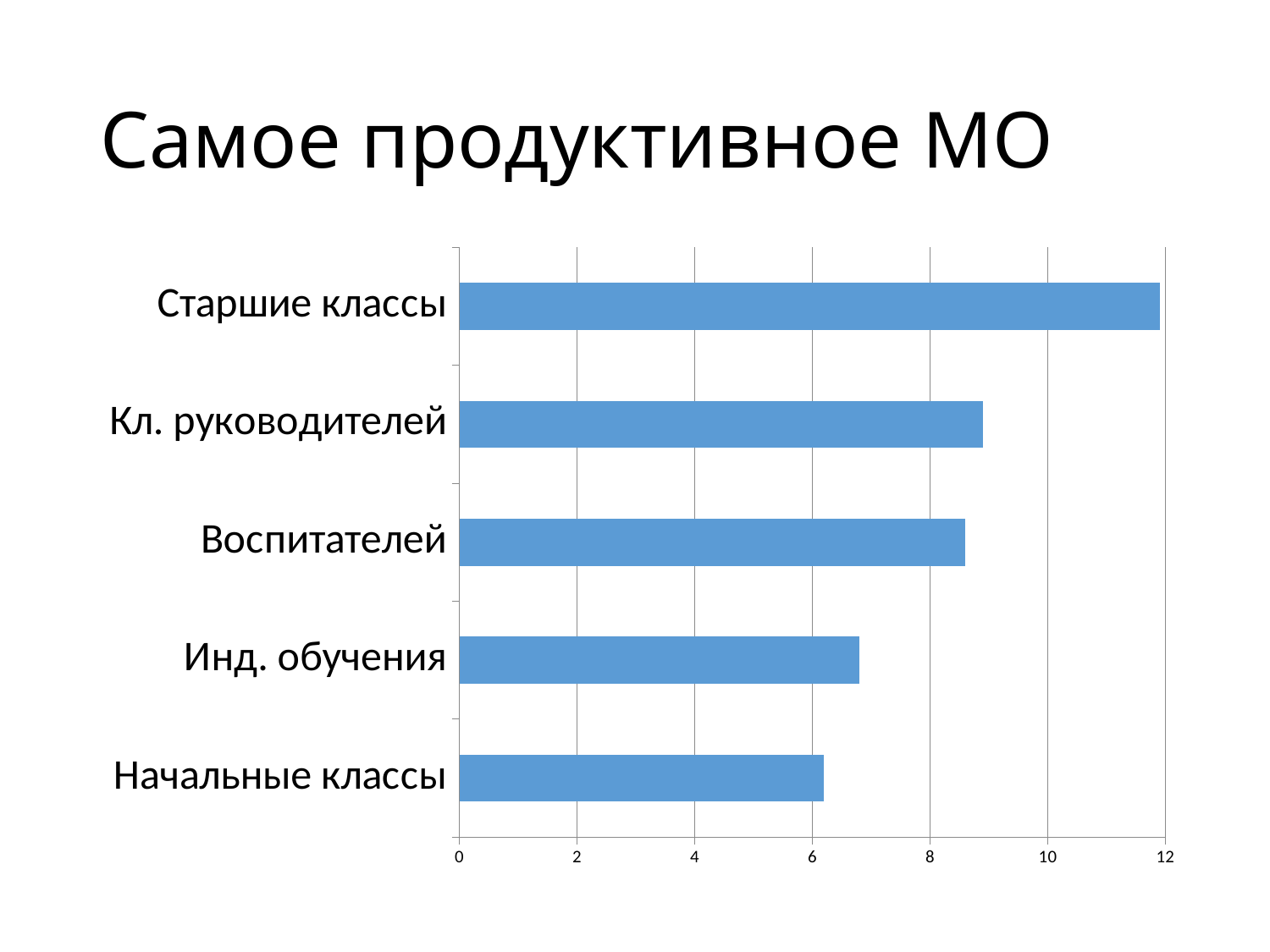
Is the value for Инд. обучения greater or less than 6? greater How many categories are shown in the chart? 5 Is the value for Старшие классы greater or less than 10? greater Is the value for Начальные классы greater or less than 8? less Which category has the lowest value? Начальные классы Which is larger, the value for Старшие классы or the value for Кл. руководителей? Старшие классы What kind of chart is shown on the slide? bar chart Which is larger, the value for Воспитателей or the value for Инд. обучения? Воспитателей What is the title of the slide with the chart? Самое продуктивное МО Which category has the highest value? Старшие классы